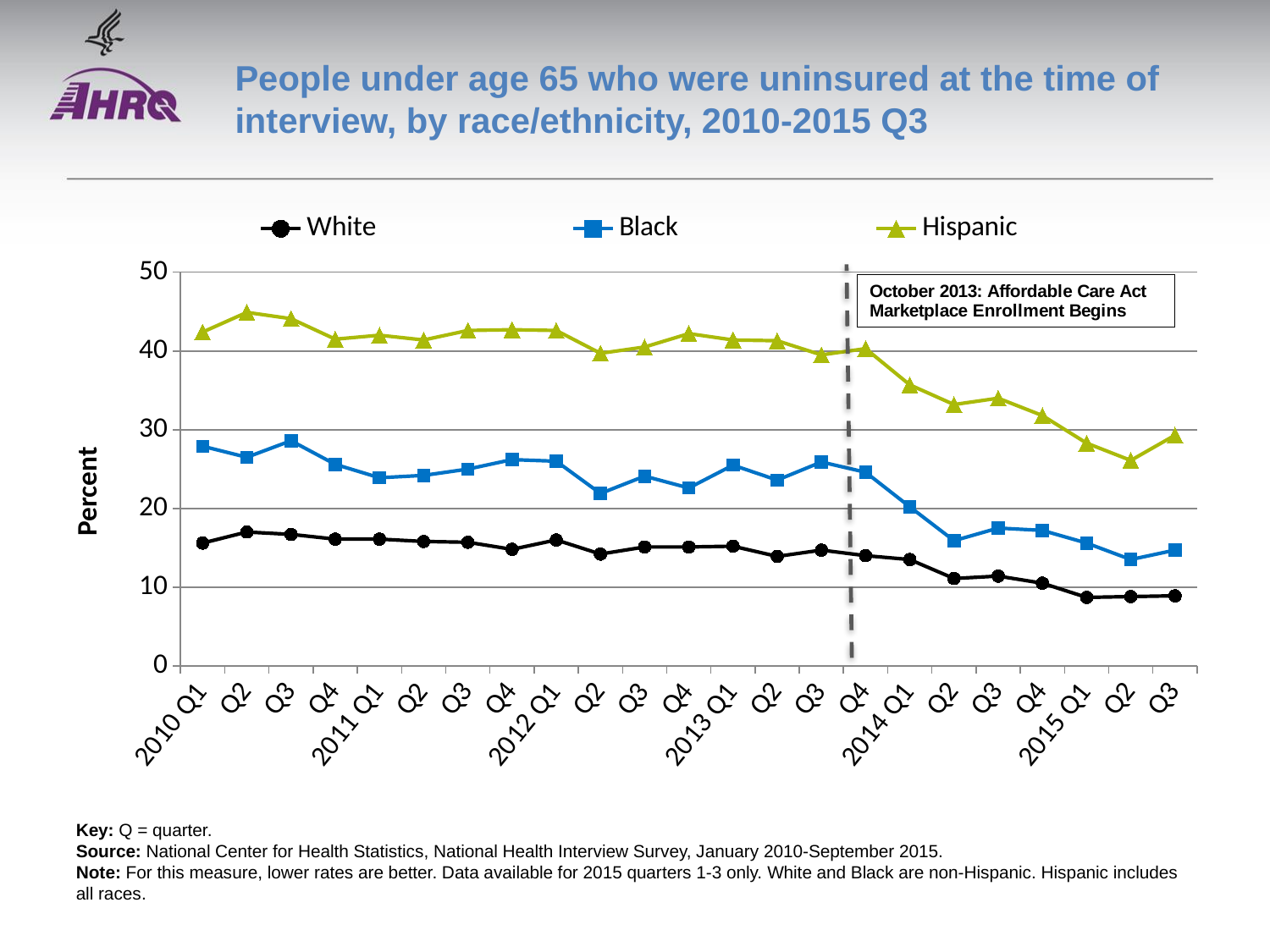
What event does the dashed vertical line on the chart mark? October 2013: Affordable Care Act Marketplace Enrollment Begins How many quarters are plotted along the x axis? 23 Is the value for White in 2015 Q1 greater or less than 10? less Does the Hispanic uninsured rate rise or fall from 2014 Q1 to 2015 Q2? fall How many series does the legend list? 3 Which race/ethnicity group has the highest uninsured rate throughout the period? Hispanic Is the value for Hispanic in 2015 Q2 greater or less than 30? less Is the value for Black in 2015 Q3 greater or less than 20? less What kind of chart is shown on the slide? line chart Which race/ethnicity group has the lowest uninsured rate throughout the period? White Which is larger in 2014 Q2, the value for Black or the value for White? Black